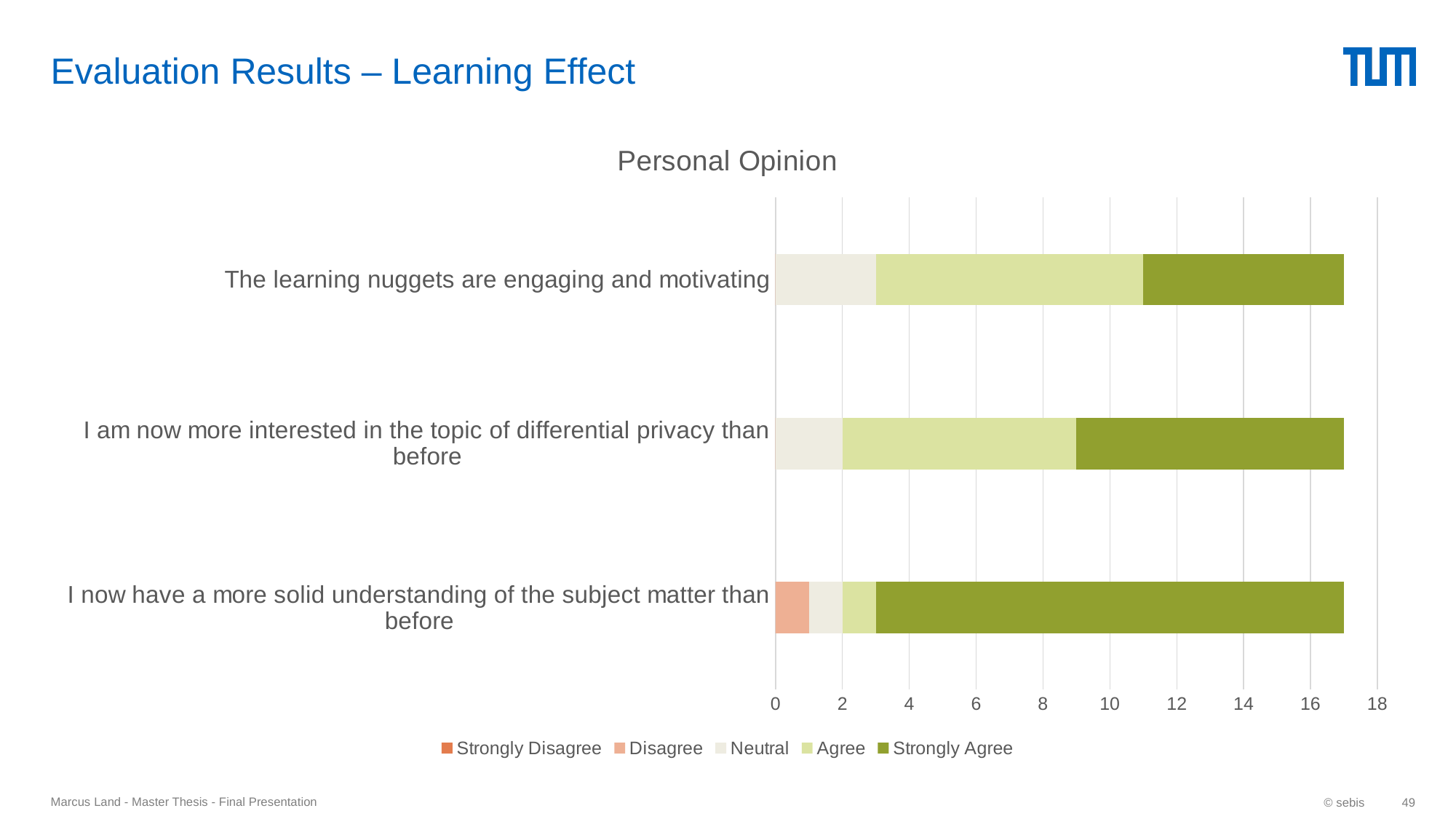
Is the Agree value for "The learning nuggets are engaging and motivating" greater or less than 4? greater How many series does the legend list? 5 What is the title of the chart? Personal Opinion How many statements (categories) are plotted in the chart? 3 Which statement has the smallest Agree segment? I now have a more solid understanding of the subject matter than before Is the total bar length for "I am now more interested in the topic of differential privacy than before" greater or less than 16? greater Which statement has the larger Strongly Agree segment: "The learning nuggets are engaging and motivating" or "I now have a more solid understanding of the subject matter than before"? I now have a more solid understanding of the subject matter than before Is the Neutral value for "The learning nuggets are engaging and motivating" greater or less than 2? greater Which statement is the only one with a Disagree segment? I now have a more solid understanding of the subject matter than before Which statement has the larger Agree segment: "The learning nuggets are engaging and motivating" or "I now have a more solid understanding of the subject matter than before"? The learning nuggets are engaging and motivating What kind of chart is shown on the slide? bar chart